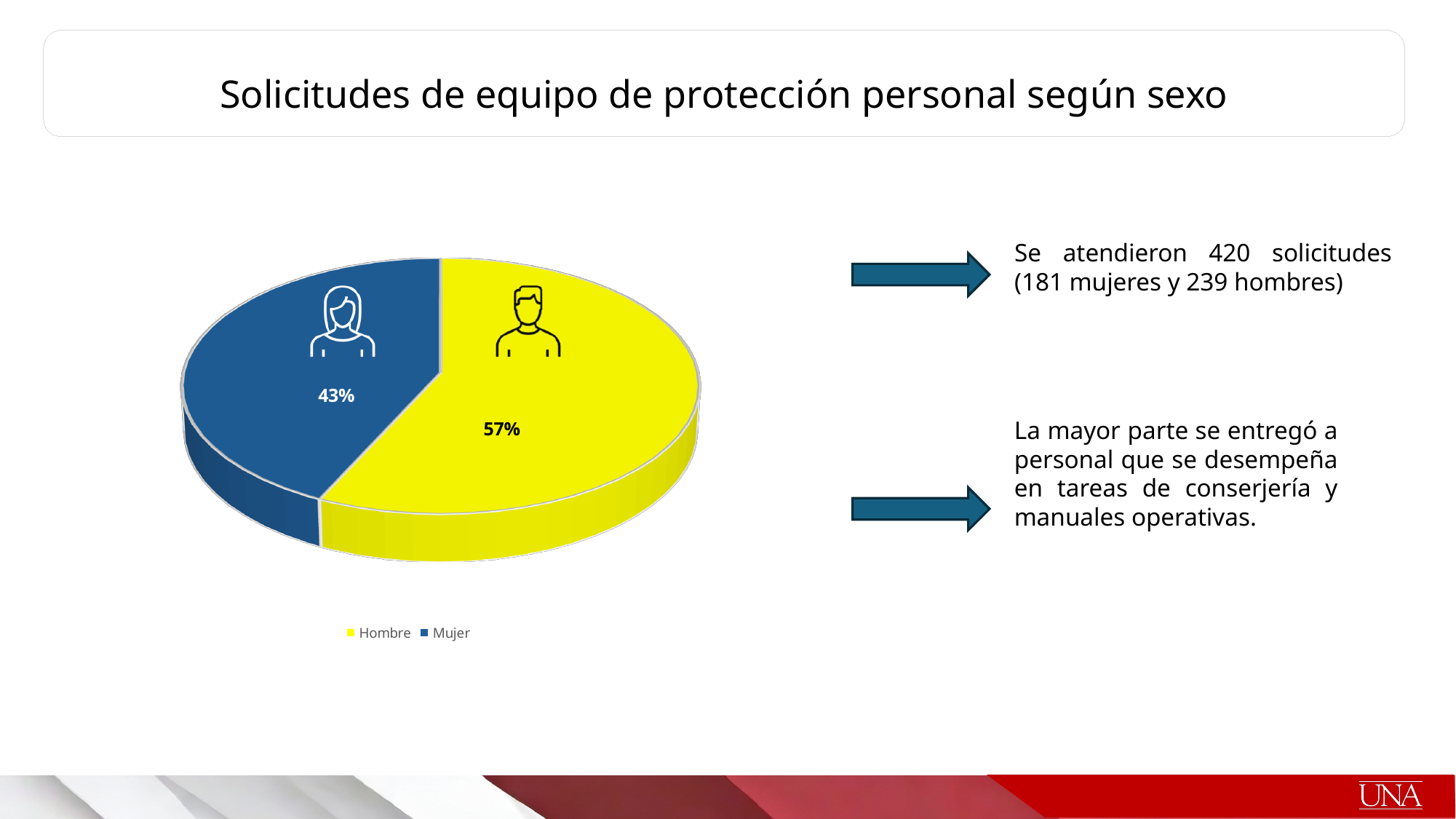
What colour is the Hombre slice? Yellow How many categories does the pie chart show? 2 What is the difference in percentage points between the Hombre and Mujer slices? 14 percentage points Which category has the largest slice of the pie? Hombre What share of the pie does Hombre represent? 57% What share of the pie does Mujer represent? 43% Which slice is larger, Hombre or Mujer? Hombre What kind of chart is shown on the slide? Pie chart How many entries does the legend list? 2 What colour is the Mujer slice? Blue Which category has the smallest slice of the pie? Mujer